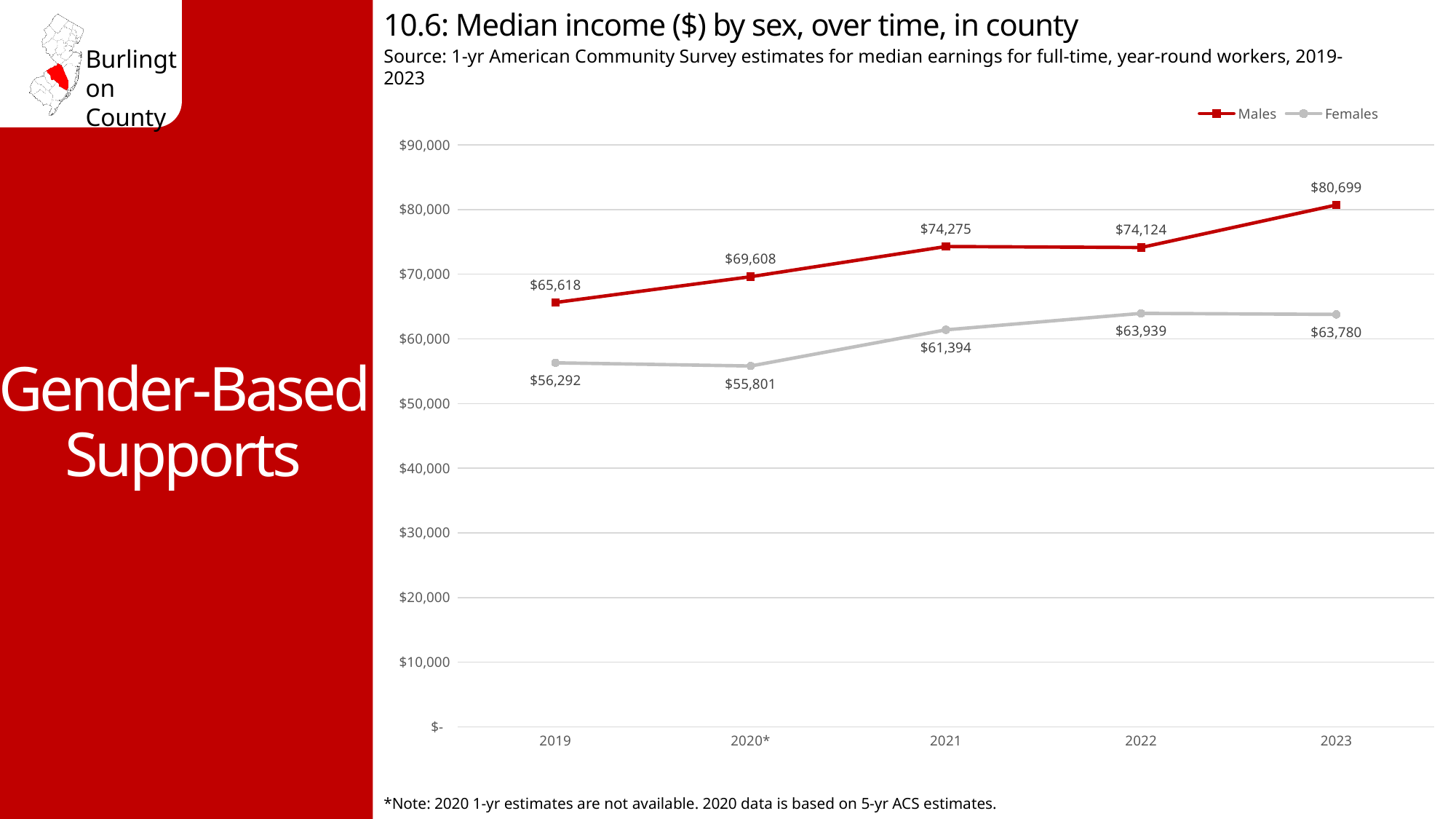
In which year was the median income for Females lowest? 2020* In which year was the median income for Males highest? 2023 What is the difference between the Males and Females median income in 2023? $16,919 What was the median income for Males in 2021? $74,275 How many series does the legend list? 2 What was the median income for Females in 2019? $56,292 What was the median income for Males in 2023? $80,699 What kind of chart is shown on the slide? Line chart Did the median income for Males generally rise or fall from 2019 to 2023? Rise What was the median income for Females in 2020*? $55,801 Which was larger in 2022, the median income for Males or for Females? Males How many years are shown on the x axis? 5